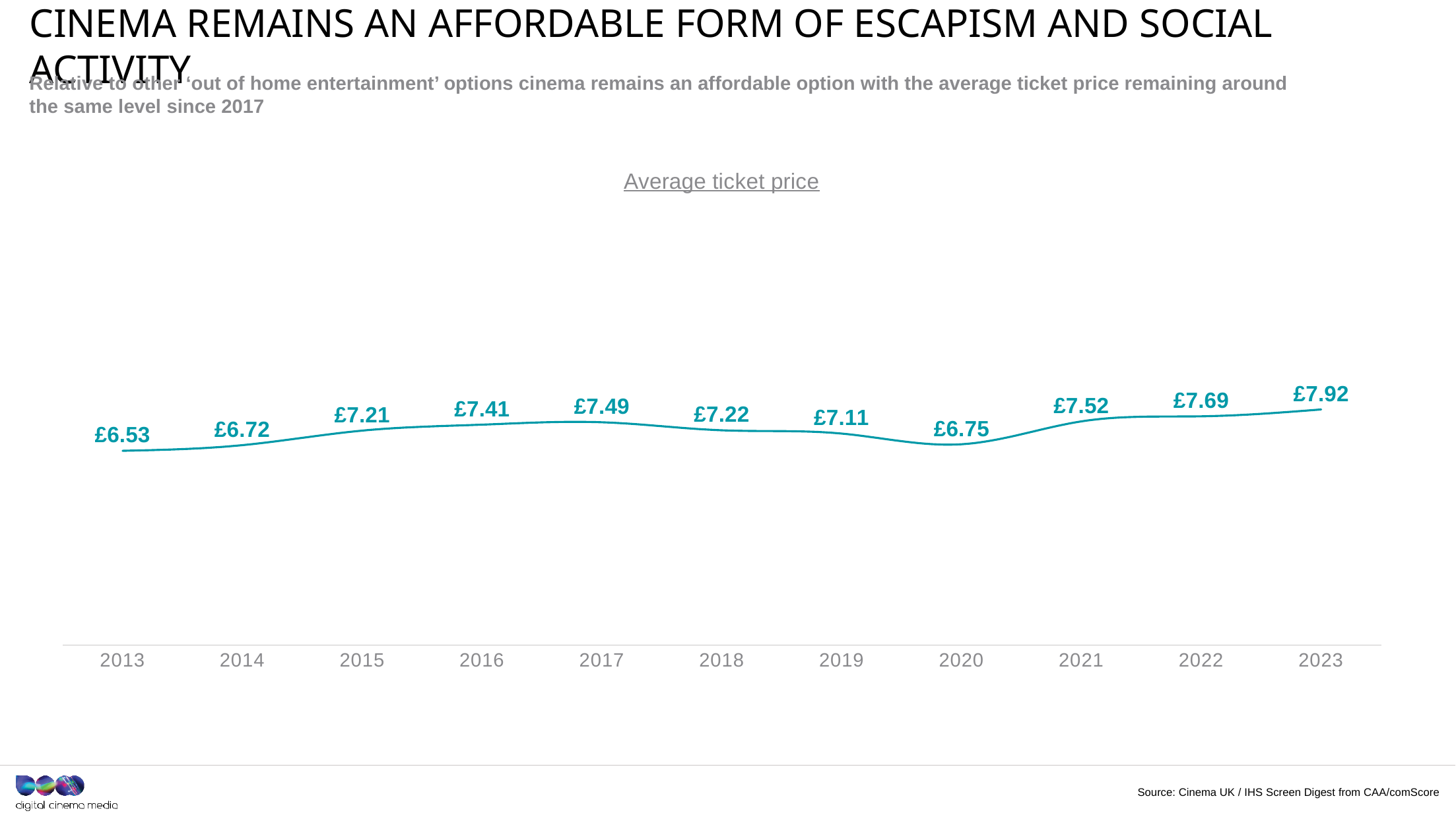
How many years are plotted on the chart? 11 What is the average ticket price for 2017? £7.49 Which year has the highest average ticket price? 2023 Which year has the lowest average ticket price? 2013 What is the difference between the average ticket price in 2023 and in 2013? £1.39 What is the average ticket price for 2013? £6.53 What kind of chart is shown on the slide? Line chart What is the title of the chart? Average ticket price Which year has a higher average ticket price, 2016 or 2019? 2016 What is the average ticket price for 2023? £7.92 What is the average ticket price for 2020? £6.75 What is the difference between the average ticket price in 2017 and in 2020? £0.74